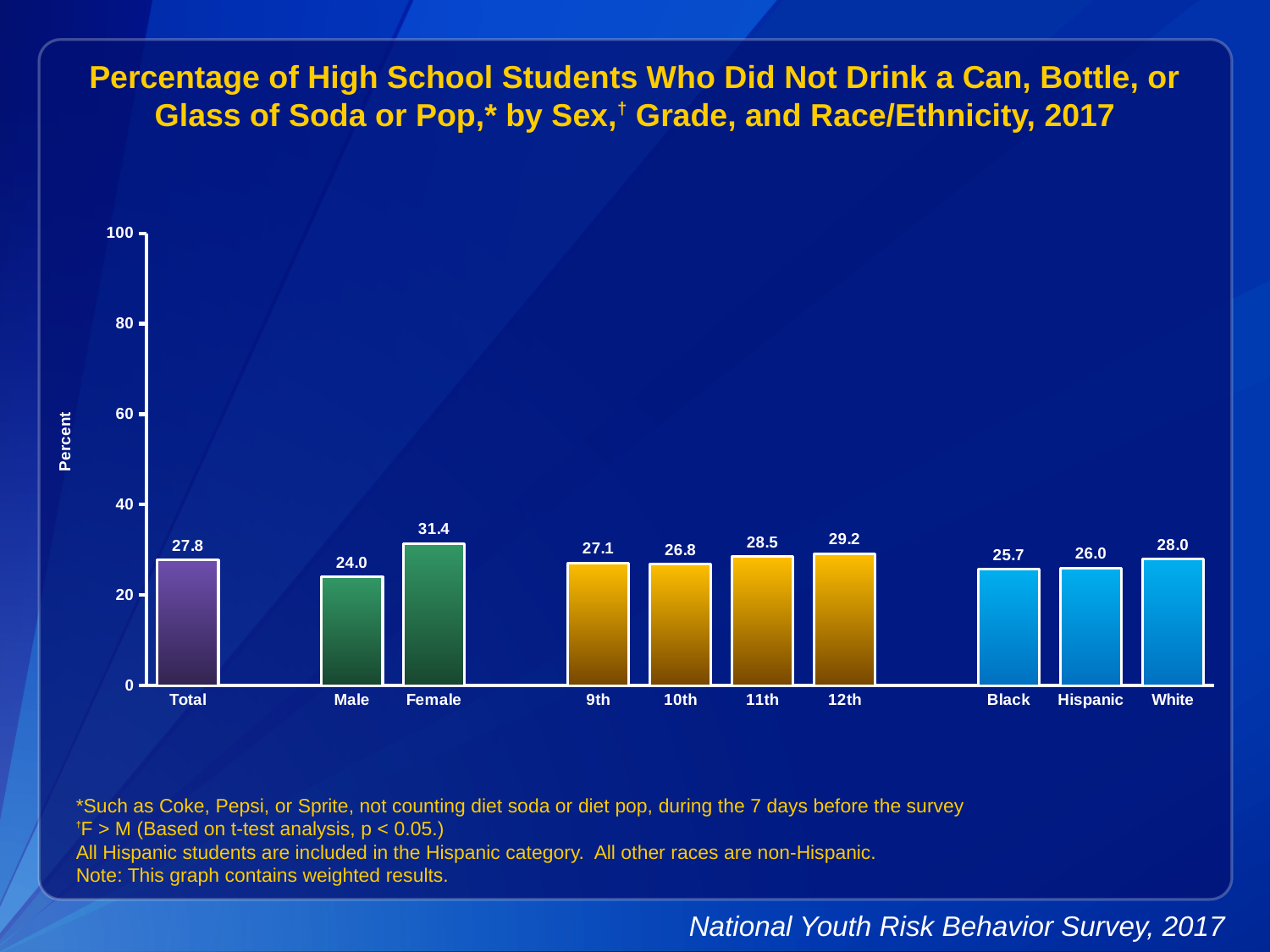
What is the value for Total? 27.8 What is the difference between the 12th grade and 9th grade values? 2.1 Which is larger, the value for White or the value for Black? White What kind of chart is shown on the slide? bar chart How many bars are shown in the chart? 10 What is the value for Hispanic students? 26.0 What is the value for Female? 31.4 What is the value for 11th grade? 28.5 Which category has the highest value? Female Which category has the lowest value? Male Is the value for Female greater or less than 40? less What is the difference between the Female and Male values? 7.4